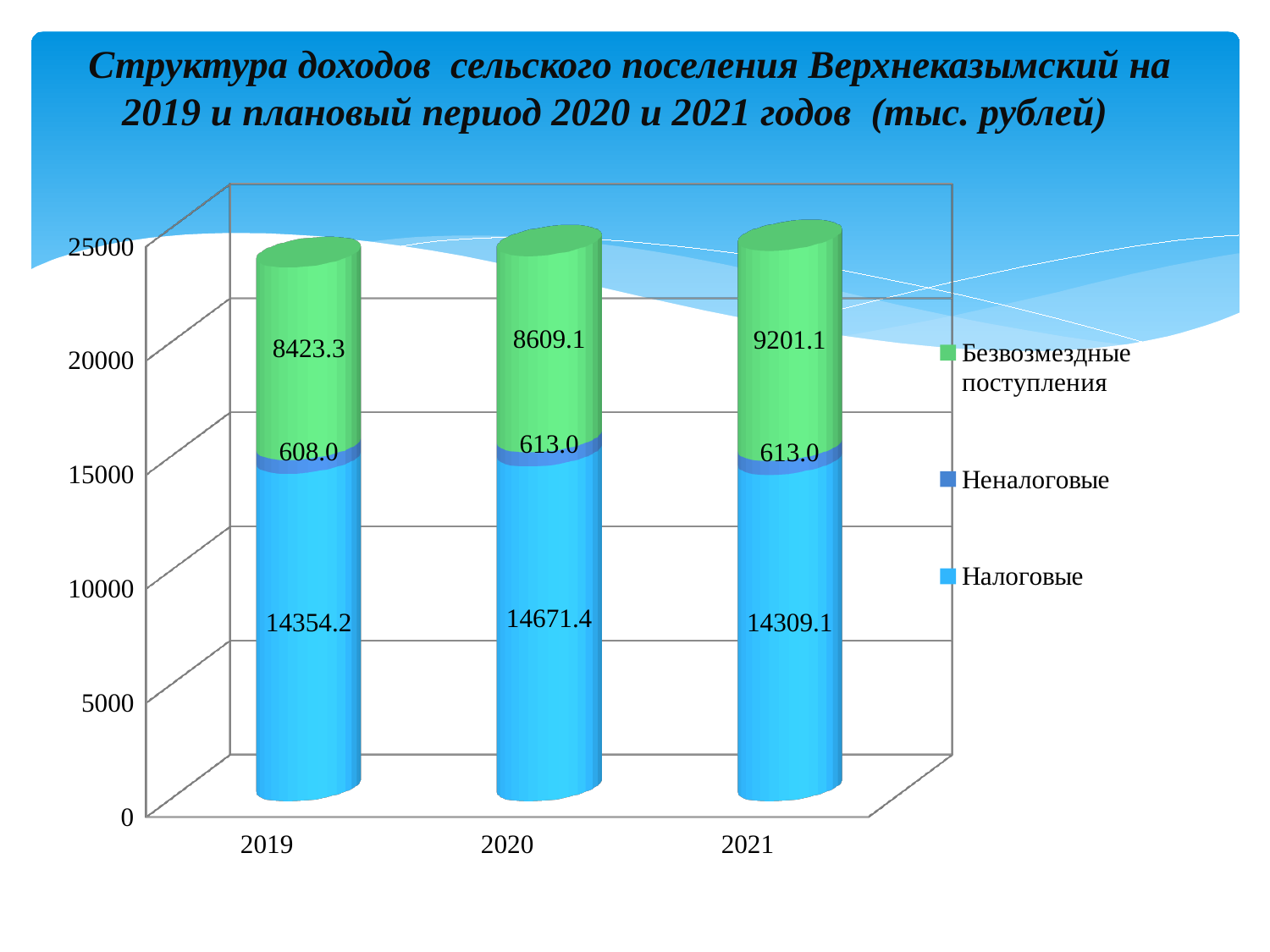
What is the value of Неналоговые for 2019? 608.0 How many years are shown on the x axis? 3 In which year is Безвозмездные поступления highest? 2021 What kind of chart is shown on the slide? Stacked bar chart What is the difference between Безвозмездные поступления in 2021 and in 2019? 777.8 How many series does the legend list? 3 Which is larger: Налоговые in 2020 or Налоговые in 2021? Налоговые in 2020 In which year is Налоговые lowest? 2021 What is the total of the stacked bar for 2019? 23385.5 What is the value of Налоговые for 2020? 14671.4 What is the value of Безвозмездные поступления for 2021? 9201.1 What is the total of the stacked bar for 2020? 23893.5